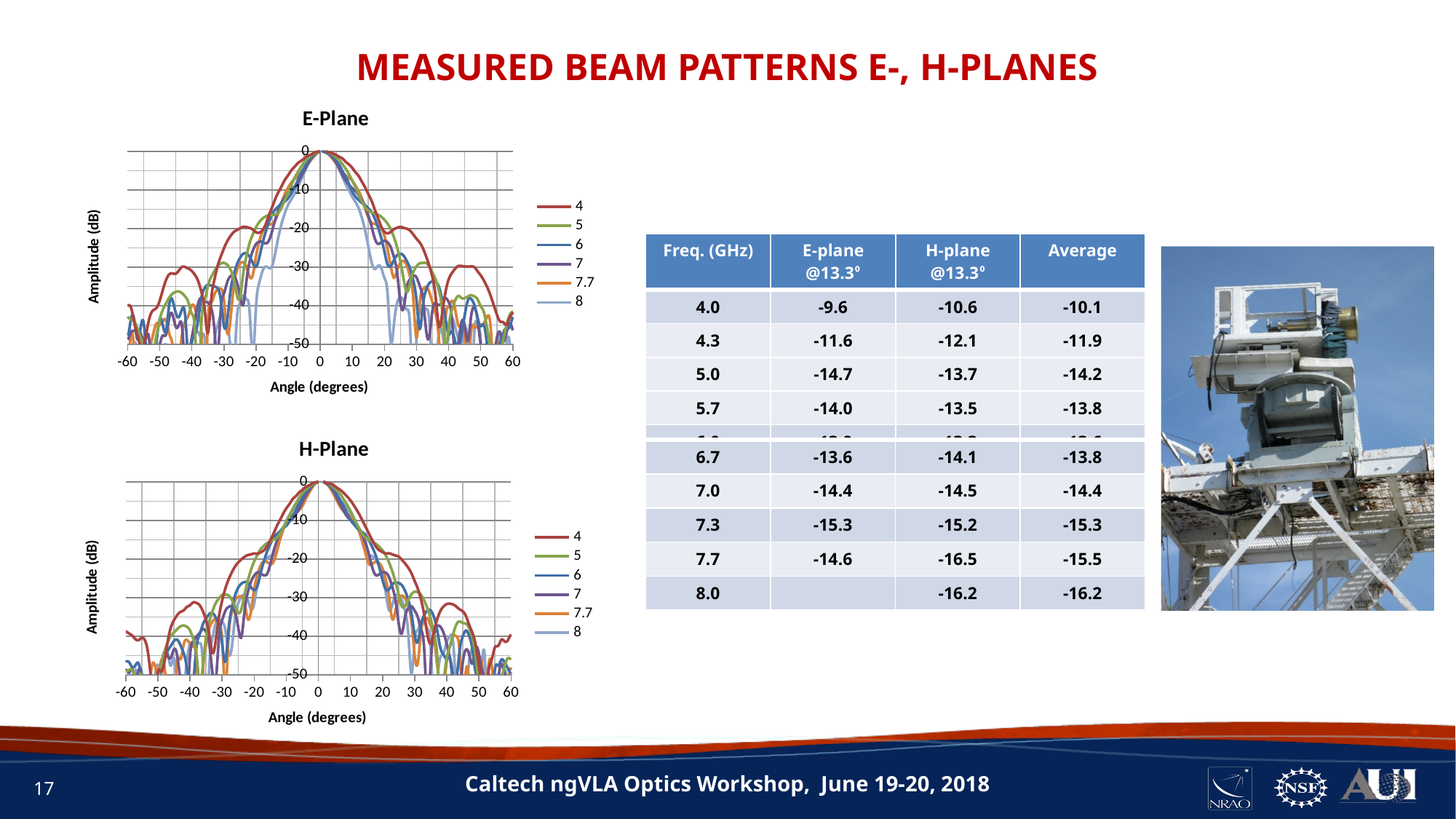
In the E-Plane chart, what is the amplitude of the series at an angle of 0 degrees? 0 What is the y-axis title of the H-Plane chart? Amplitude (dB) In the H-Plane chart, what is the amplitude of the series at an angle of 0 degrees? 0 In the E-Plane chart, do the values rise or fall as the angle goes from -60 to 0 degrees? rise In the E-Plane chart, which series has the highest amplitude at 30 degrees, series 4 or series 8? 4 In the E-Plane chart, is the value for series 4 at 60 degrees greater or less than -30? less What kind of chart is the E-Plane chart? line chart In the E-Plane chart, is the value for series 4 at 5 degrees greater or less than -10? greater In the H-Plane chart, do the values rise or fall as the angle goes from 0 to 60 degrees? fall In the H-Plane chart, is the value for series 8 at 60 degrees greater or less than -30? less What are the legend entries of the E-Plane chart? 4, 5, 6, 7, 7.7, 8 How many series does the legend of the H-Plane chart list? 6